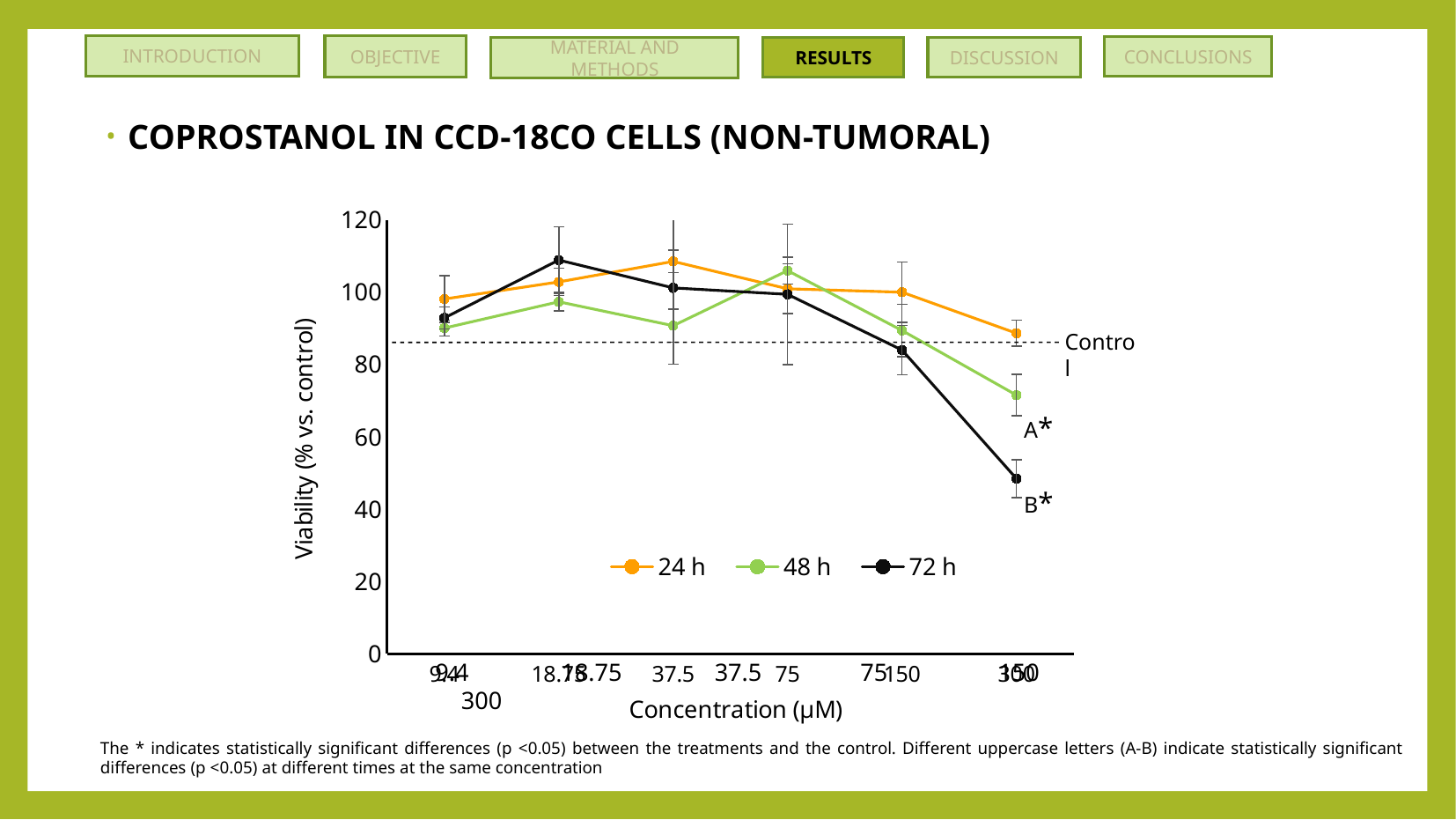
Is the 24 h viability at 37.5 µM greater or less than 100? greater How many concentration points are plotted for each series? 6 Is the 48 h viability at 300 µM greater or less than 80? less What is the title of the y axis? Viability (% vs. control) At 300 µM, which series has the higher viability, 24 h or 72 h? 24 h For the 72 h series, at which concentration is viability highest? 18.75 How many series does the legend list? 3 Is the 24 h viability at 300 µM greater or less than 80? greater What kind of chart is shown on the slide? line chart Which series has the lowest viability at 300 µM? 72 h Does the 72 h viability rise or fall from 75 µM to 300 µM? fall